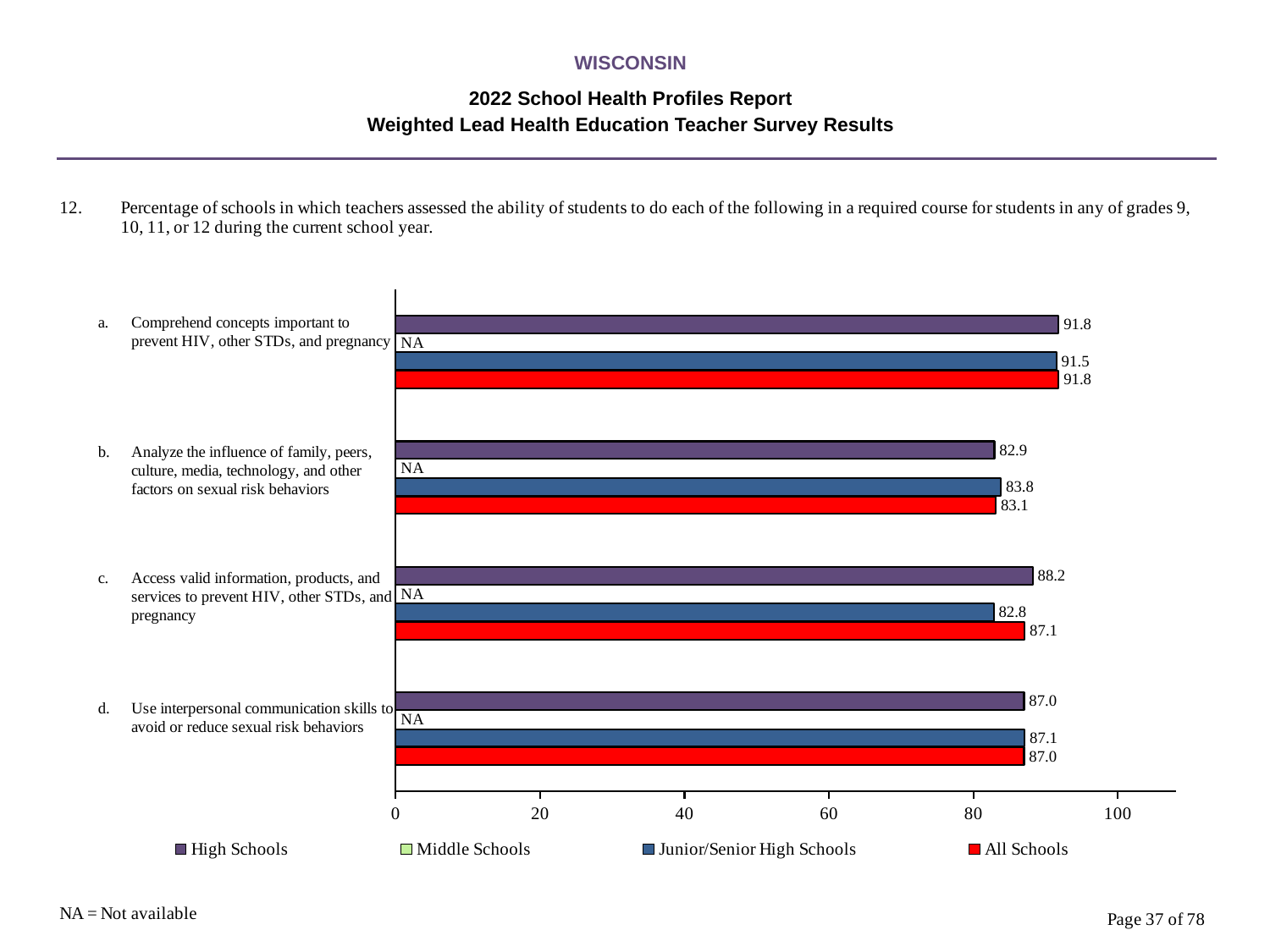
What is the Junior/Senior High Schools value for item c, access valid information, products, and services to prevent HIV, other STDs, and pregnancy? 82.8 What kind of chart is shown on the slide? bar chart For item b, which is larger: the High Schools value or the Junior/Senior High Schools value? Junior/Senior High Schools What is shown for Middle Schools for item d, use interpersonal communication skills to avoid or reduce sexual risk behaviors? NA How many items (categories) are plotted on the chart? 4 What is the difference between the High Schools and Junior/Senior High Schools values for item c? 5.4 What is the All Schools value for item b, analyze the influence of family, peers, culture, media, technology, and other factors on sexual risk behaviors? 83.1 Which item has the lowest High Schools value? b. Analyze the influence of family, peers, culture, media, technology, and other factors on sexual risk behaviors Is the All Schools value for item c greater or less than 80? greater Which item has the highest All Schools value? a. Comprehend concepts important to prevent HIV, other STDs, and pregnancy How many series does the legend list? 4 What is the High Schools value for item a, comprehend concepts important to prevent HIV, other STDs, and pregnancy? 91.8